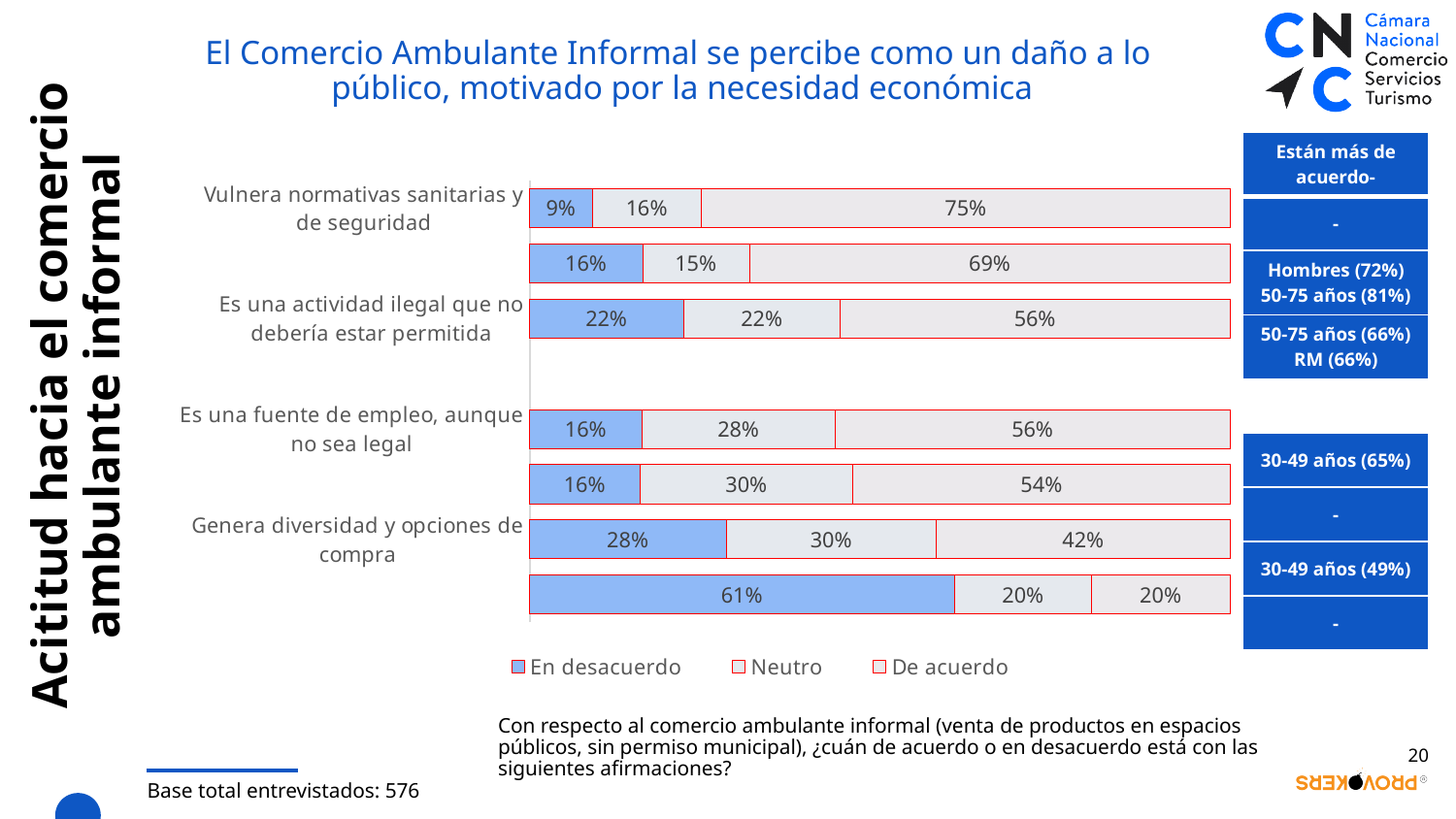
What is the "Neutro" value for "Es una fuente de empleo, aunque no sea legal"? 28% What is the total of the stacked bar for "Vulnera normativas sanitarias y de seguridad"? 100% What is the "De acuerdo" value for "Es una actividad ilegal que no debería estar permitida"? 56% Which statement has the lowest "En desacuerdo" percentage? Vulnera normativas sanitarias y de seguridad What are the three legend entries of the chart? En desacuerdo, Neutro, De acuerdo For "Vulnera normativas sanitarias y de seguridad", what is the difference between the "De acuerdo" and "En desacuerdo" percentages? 66% Which statement has the highest "De acuerdo" percentage? Vulnera normativas sanitarias y de seguridad What percentage of respondents answered "De acuerdo" for "Vulnera normativas sanitarias y de seguridad"? 75% What is the "En desacuerdo" value for "Genera diversidad y opciones de compra"? 28% How many series does the chart legend list? 3 What kind of chart is shown on the slide? Stacked bar chart Which has a larger "En desacuerdo" value: "Genera diversidad y opciones de compra" or "Vulnera normativas sanitarias y de seguridad"? Genera diversidad y opciones de compra